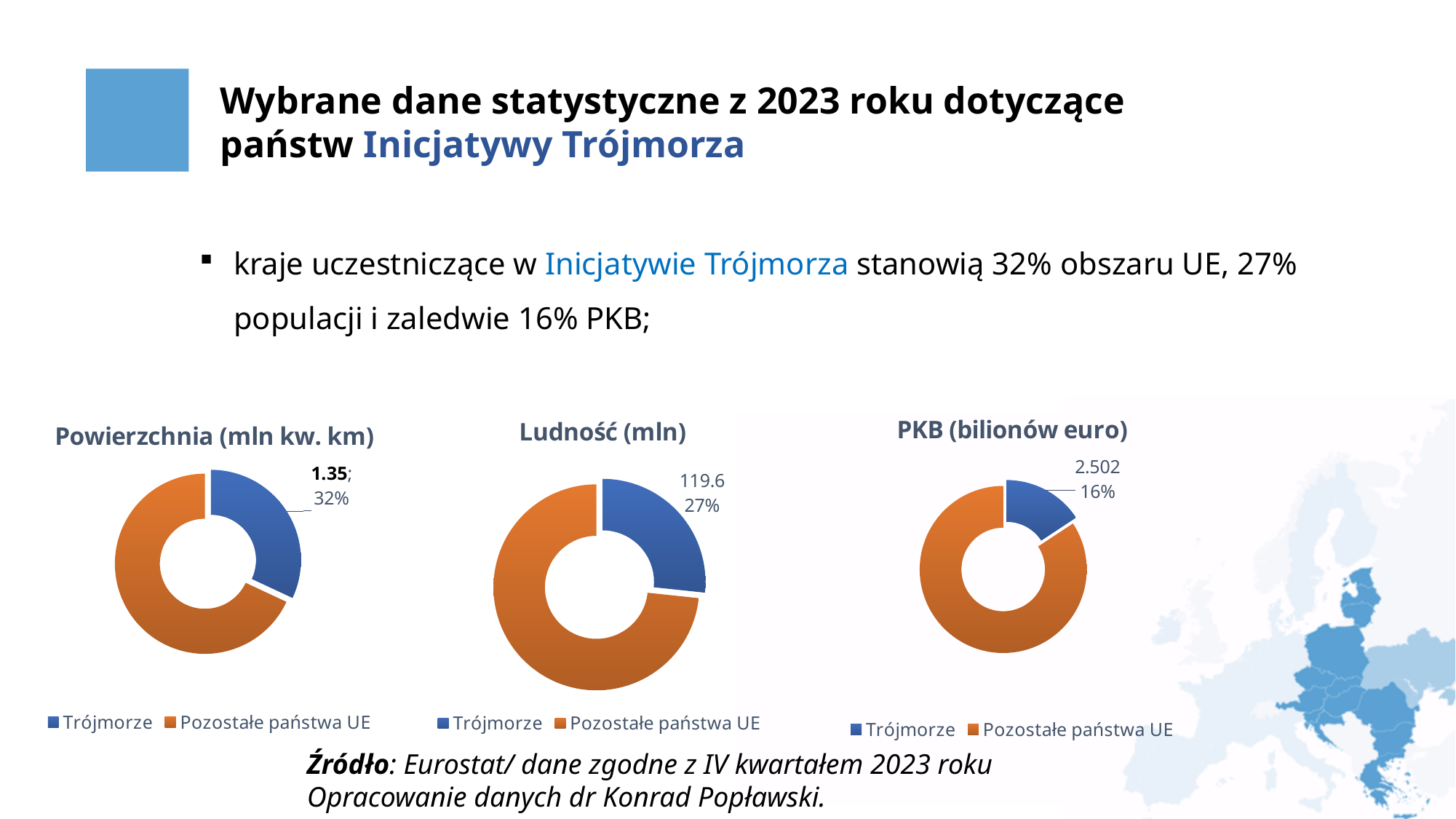
What type of chart is the 'Ludność (mln)' chart? Doughnut (pie) chart In the 'Ludność (mln)' chart, what value is shown for Trójmorze? 119.6 In the 'PKB (bilionów euro)' chart, which slice is larger: Trójmorze or Pozostałe państwa UE? Pozostałe państwa UE How many categories does the legend of the 'Ludność (mln)' chart list? 2 What colour represents Trójmorze in the charts? Blue In the 'Powierzchnia (mln kw. km)' chart, what share of the doughnut does Trójmorze represent? 32% In the 'Powierzchnia (mln kw. km)' chart, what value is shown for Trójmorze? 1.35 How many doughnut charts are shown on the slide? 3 In the 'Powierzchnia (mln kw. km)' chart, which category has the smallest slice? Trójmorze In the 'PKB (bilionów euro)' chart, what share of the doughnut does Trójmorze represent? 16% In the 'PKB (bilionów euro)' chart, what value is shown for Trójmorze? 2.502 In the 'Ludność (mln)' chart, what percentage share is labelled for Trójmorze? 27%